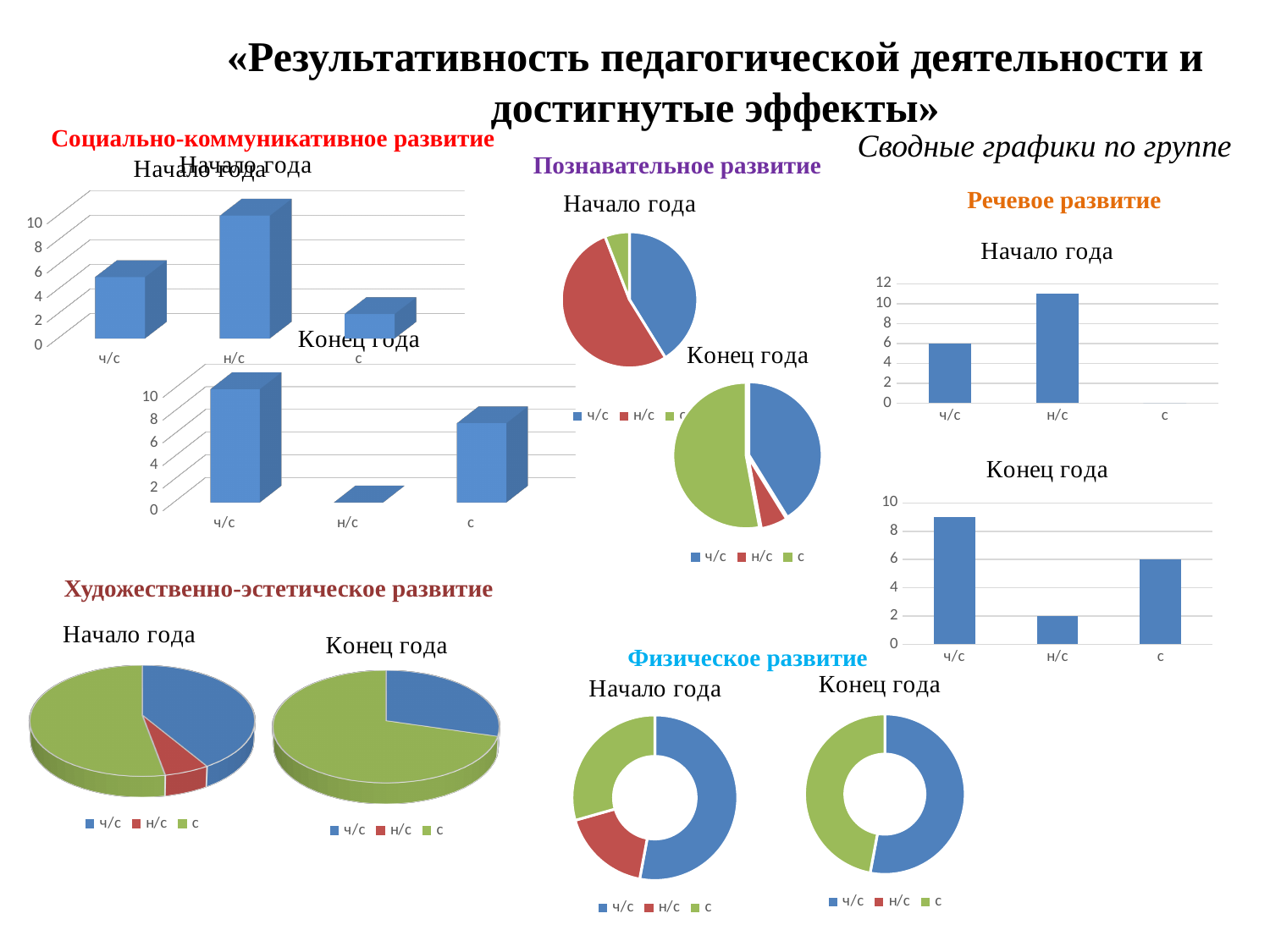
In the Социально-коммуникативное развитие 'Конец года' chart, which category has the lowest value? н/с In the Речевое развитие 'Начало года' chart, which category has the highest value? н/с In the Социально-коммуникативное развитие 'Начало года' chart, which category has the highest value? н/с In the Речевое развитие 'Конец года' chart, which is larger, ч/с or с? ч/с In the Речевое развитие 'Конец года' chart, what is the value for н/с? 2 In the Речевое развитие 'Начало года' chart, is the value for н/с greater or less than 10? greater In the Художественно-эстетическое развитие 'Конец года' chart, which category has the largest slice? с In the Речевое развитие 'Конец года' chart, is the value for ч/с greater or less than 8? greater How many entries does the legend of the Физическое развитие 'Начало года' chart list? 3 In the Речевое развитие 'Конец года' chart, what is the value for с? 6 What kind of chart is the Познавательное развитие 'Конец года' chart? pie chart In the Речевое развитие 'Начало года' chart, what is the value for ч/с? 6